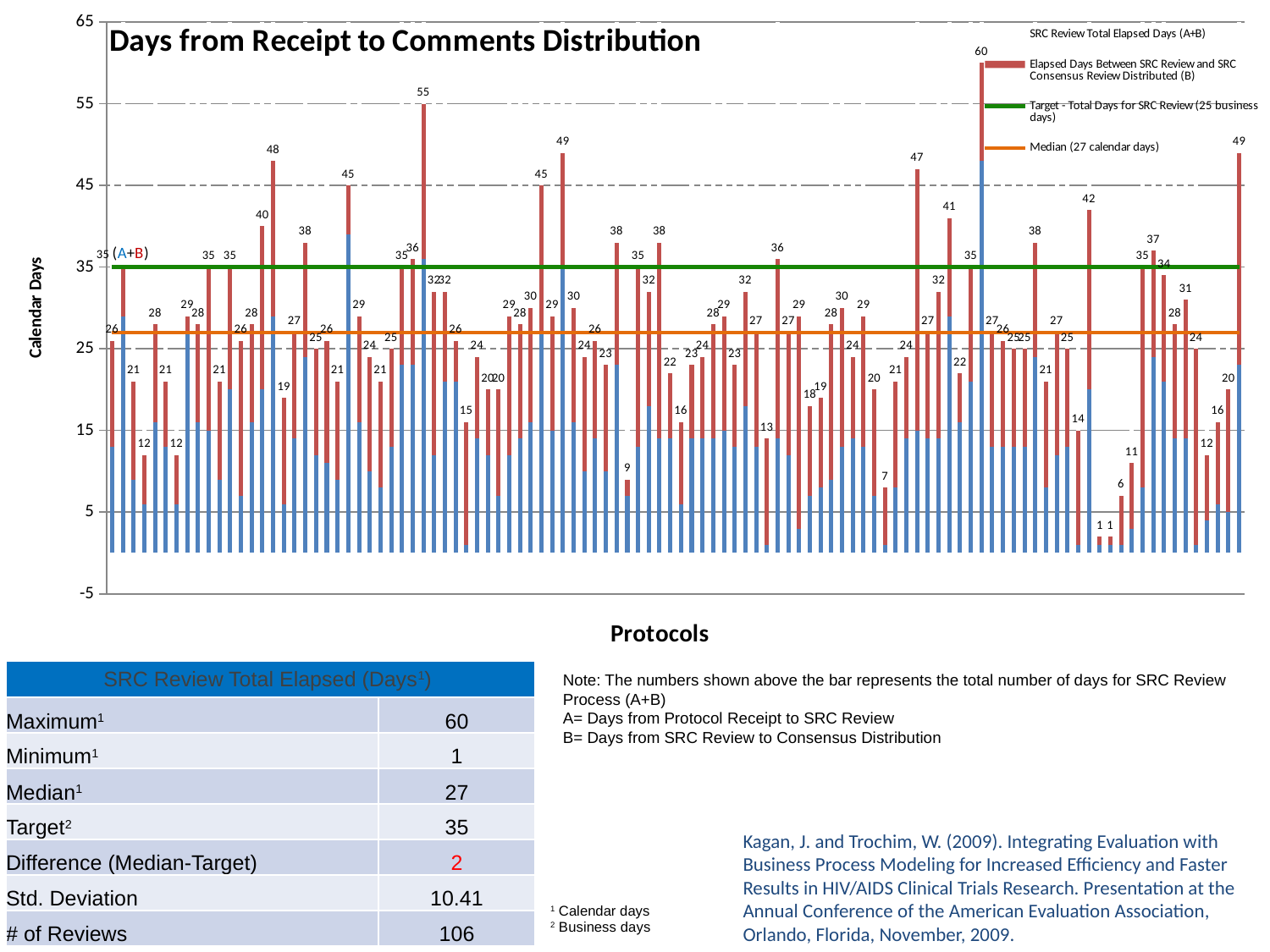
What is the label of the vertical axis of the chart? Calendar Days What is the difference between the highest labelled bar total (60) and the lowest labelled bar total (1)? 59 What kind of chart is shown on the slide? bar chart What is the highest total value labelled on any bar in the chart? 60 What is the title of the chart? Days from Receipt to Comments Distribution What is the lowest total value labelled on any bar in the chart? 1 Which is larger, the highest labelled bar total of 60 or the Target line value of 35? 60 According to the legend, how many business days is the Target line for total days for SRC Review? 25 business days According to the legend, how many calendar days is the Median line? 27 calendar days Is the orange Median line on the chart greater or less than 30 calendar days? less How many entries does the chart's legend list? 4 Is the green Target line on the chart greater or less than 30 calendar days? greater